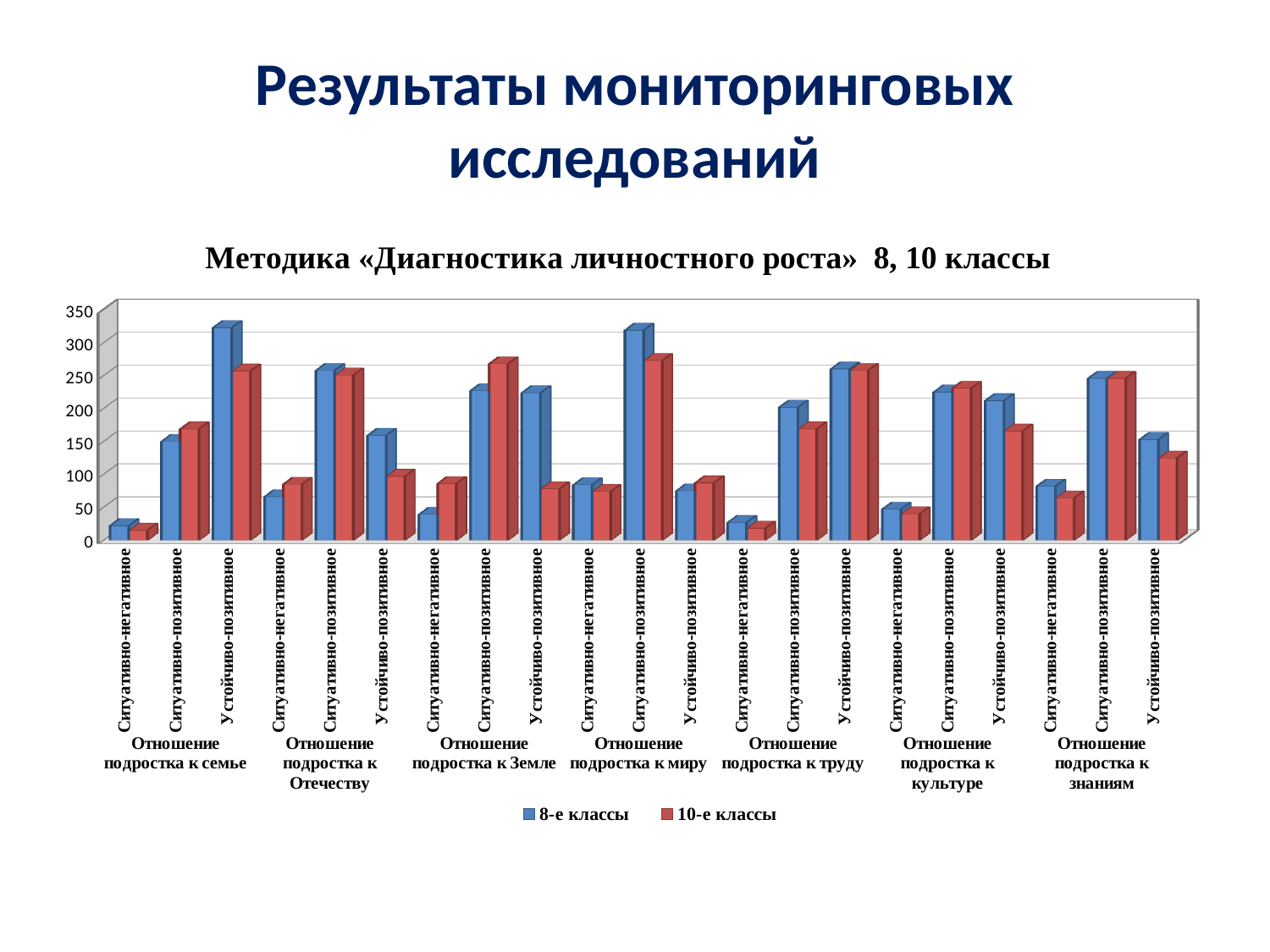
Is the value for 10-е классы, Ситуативно-позитивное, Отношение подростка к Земле greater or less than 200? greater Is the value for 8-е классы, Устойчиво-позитивное, Отношение подростка к семье greater or less than 300? greater What kind of chart is shown on the slide? Bar chart What are the two series named in the legend? 8-е классы and 10-е классы How many category groups (Отношение подростка к ...) are shown along the x axis? 7 For Ситуативно-негативное in Отношение подростка к Земле, which series has the larger value, 8-е классы or 10-е классы? 10-е классы For Устойчиво-позитивное in Отношение подростка к Земле, which series has the larger value, 8-е классы or 10-е классы? 8-е классы Is the value for 8-е классы, Ситуативно-негативное, Отношение подростка к семье greater or less than 50? less How many series does the legend list? 2 How many bars are plotted for the 8-е классы series in total? 21 What is the title of the chart? Методика «Диагностика личностного роста» 8, 10 классы